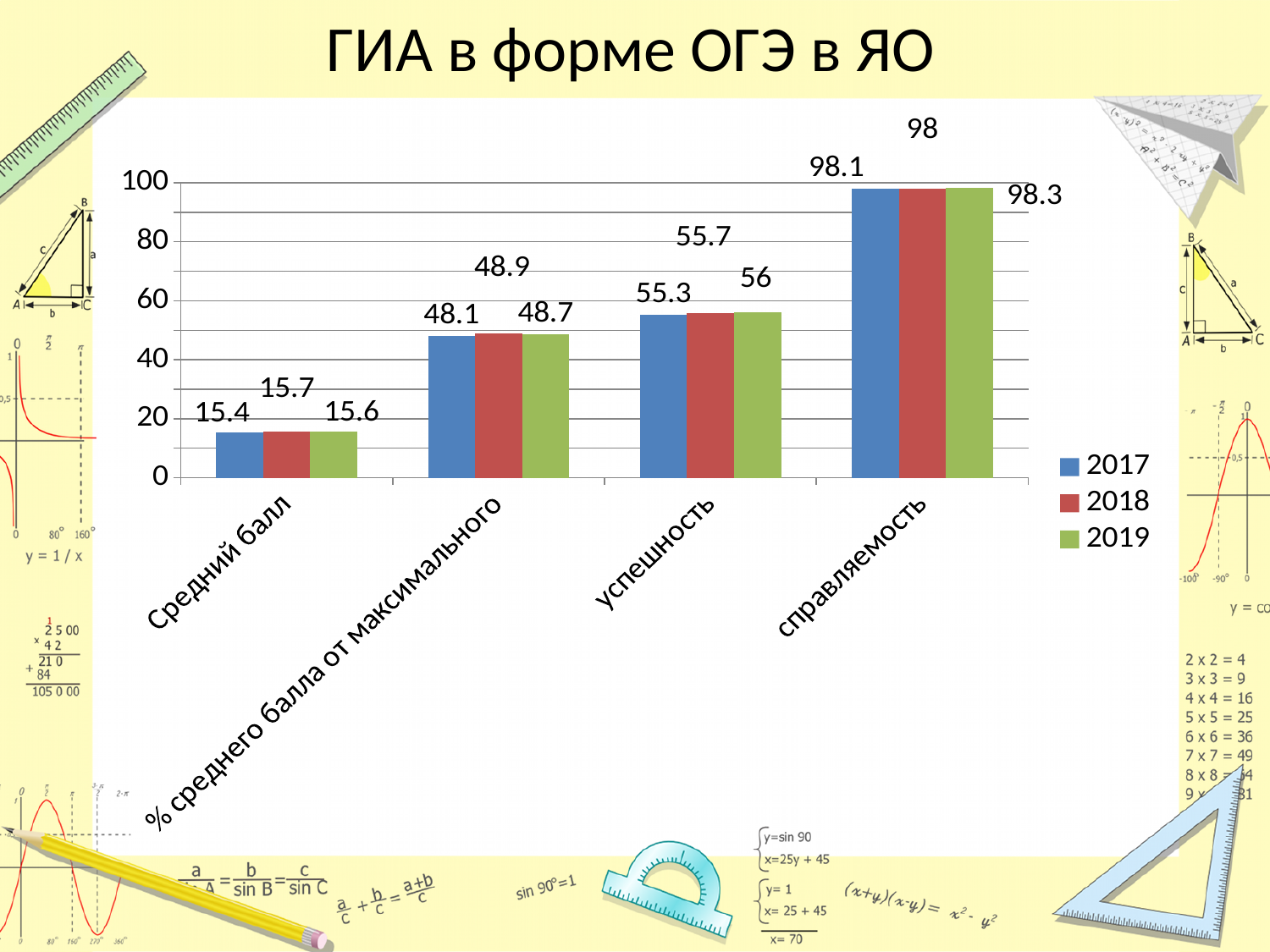
What is the value for 2018 in the category '% среднего балла от максимального'? 48.9 How many series does the legend list? 3 How many categories are shown on the x axis? 4 Which category has the lowest values across all years? Средний балл Which category has the highest values across all years? справляемость Is the value for 2017 in 'успешность' greater or less than 60? less What is the difference between the 2019 and 2017 values for 'успешность'? 0.7 What is the title of the chart? ГИА в форме ОГЭ в ЯО What is the value for 2019 in the category 'успешность'? 56 What type of chart is shown on the slide? bar chart What is the value for 2018 in the category 'справляемость'? 98 What is the value for 2017 in the category 'Средний балл'? 15.4